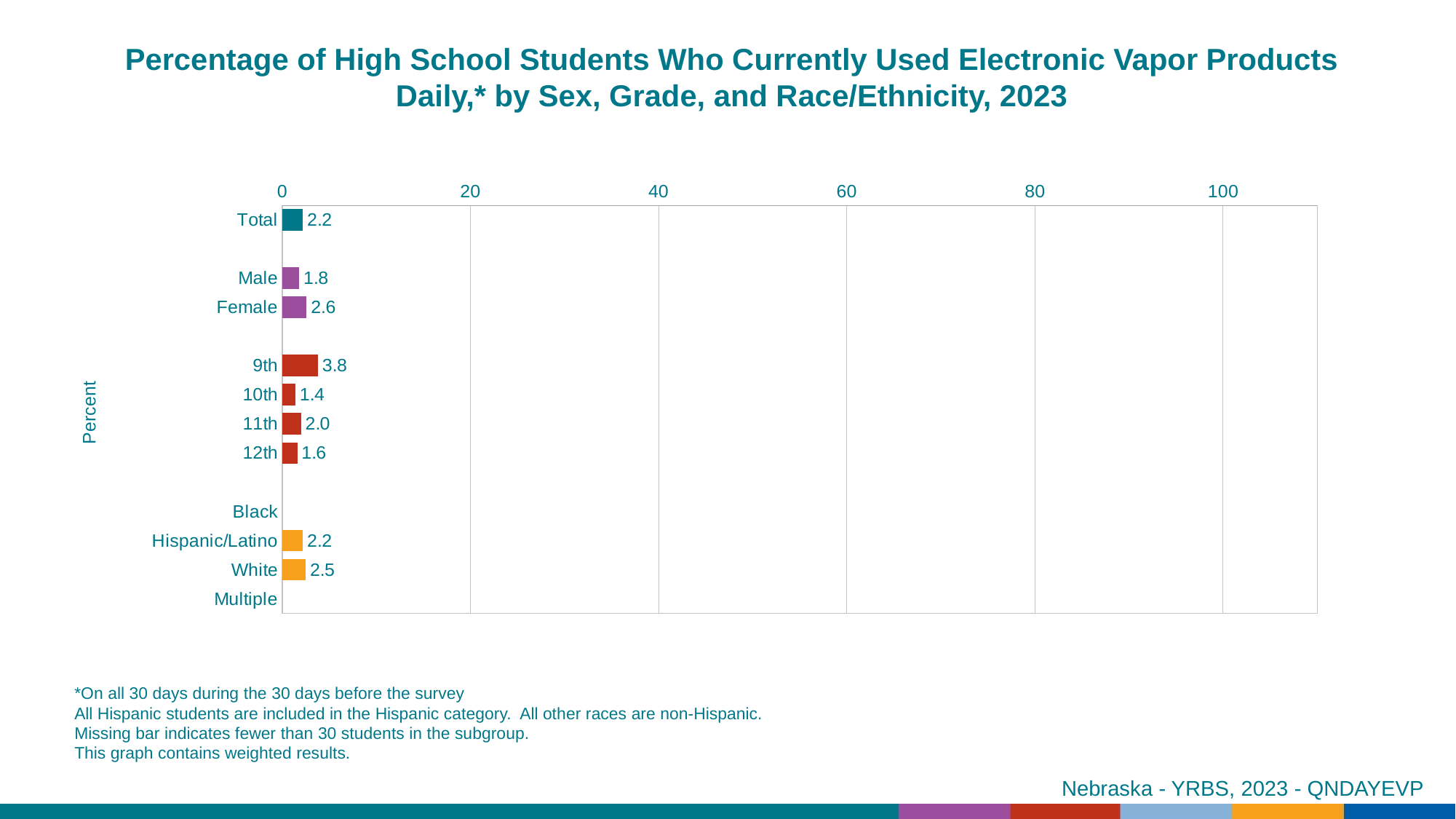
What is the value for 9th grade? 3.8 What kind of chart is this? bar chart What is the value for White? 2.5 Is the value for 9th grade greater or less than 20? less Which grade has the lowest value? 10th How many categories have no bar shown? 2 What is the difference between the Female and Male values? 0.8 Which is larger, the value for 11th grade or 12th grade? 11th What is the label on the vertical axis? Percent Which grade has the highest value? 9th What is the value for Female? 2.6 What is the value for Total? 2.2